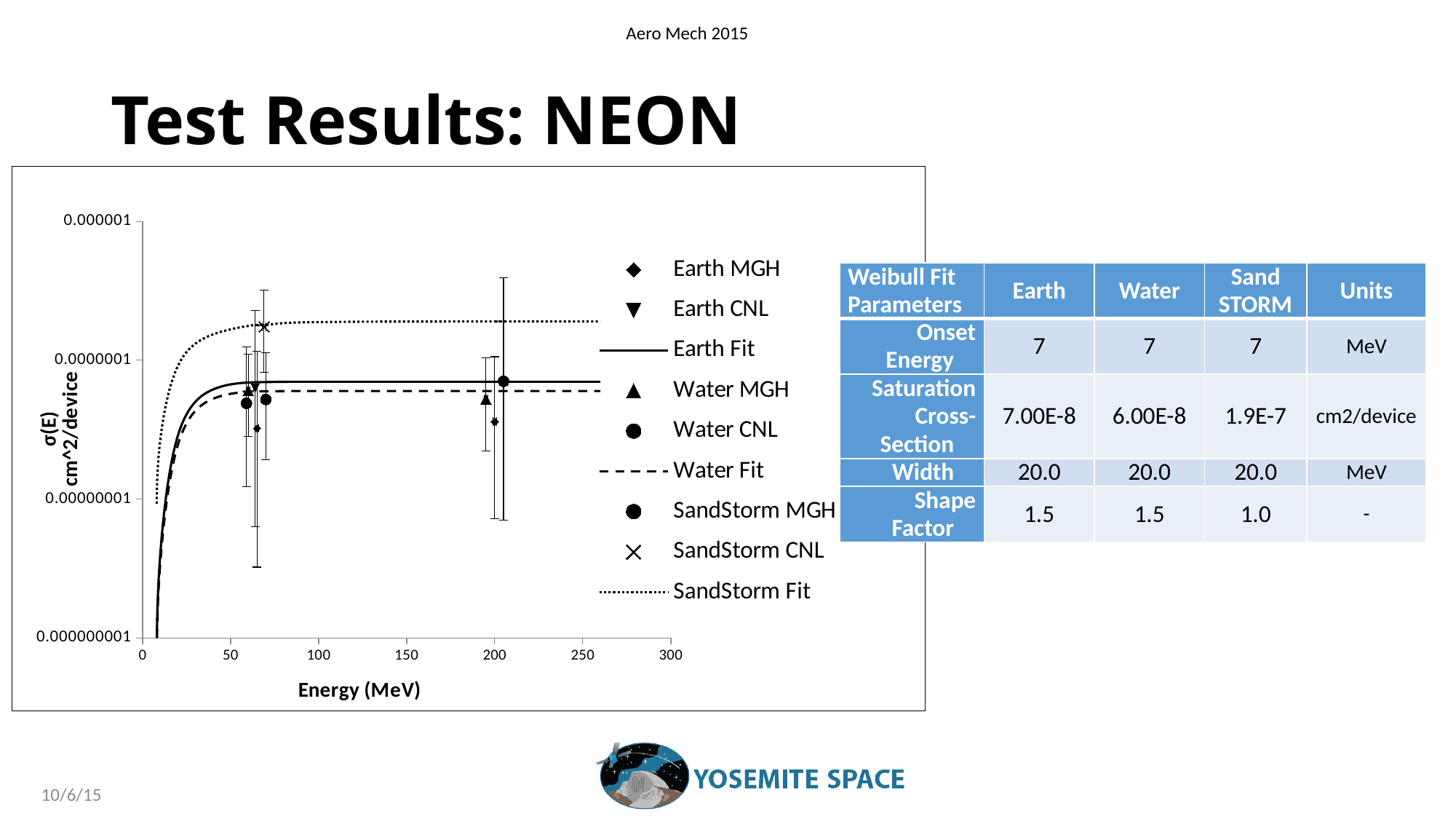
How do the fit lines behave as energy increases along the x axis? They rise steeply then level off Is the plateau value of the SandStorm Fit line greater or less than 0.0000001? greater Is the SandStorm CNL data point near 70 MeV greater or less than 0.0000001? greater What kind of chart is shown on the slide? Scatter chart with fit lines How many entries does the chart legend list? 9 Which is higher on the chart, the SandStorm Fit line or the Water Fit line? SandStorm Fit Is the plateau value of the Earth Fit line greater or less than 0.0000001? less How many fit lines are plotted on the chart? 3 What is the label of the x axis of the chart? Energy (MeV) Which fit line reaches the highest plateau value on the chart? SandStorm Fit What is the label of the y axis of the chart? σ(E) cm^2/device